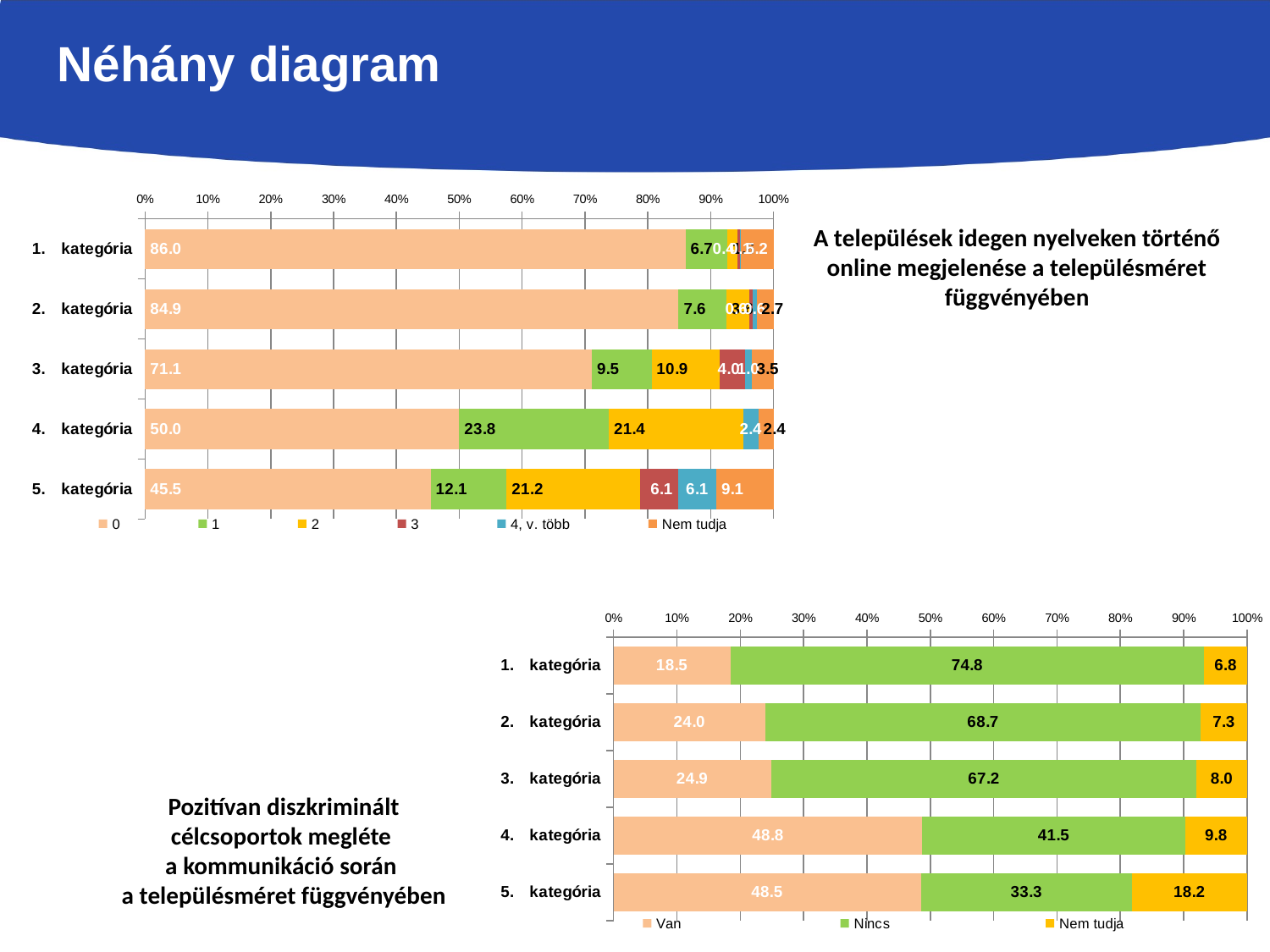
In the top chart, what is the value of the "2" series for 3. kategória? 10.9 How many categories are shown in the bottom chart? 5 In the bottom chart, which category has the highest "Van" value? 4. kategória In the top chart, what is the value of the "0" series for 5. kategória? 45.5 In the top chart, what is the difference between the "1" series values for 4. kategória and 5. kategória? 11.7 In the top chart, which category has the highest value for the "0" series? 1. kategória In the bottom chart, what is the "Nem tudja" value for 5. kategória? 18.2 In the bottom chart, is the "Van" value for 1. kategória larger or smaller than the "Van" value for 3. kategória? smaller How many series does the legend of the top chart list? 6 What type of chart is the bottom chart? Stacked bar chart In the top chart, which category has the lowest value for the "0" series? 5. kategória In the bottom chart, what is the "Nincs" value for 2. kategória? 68.7